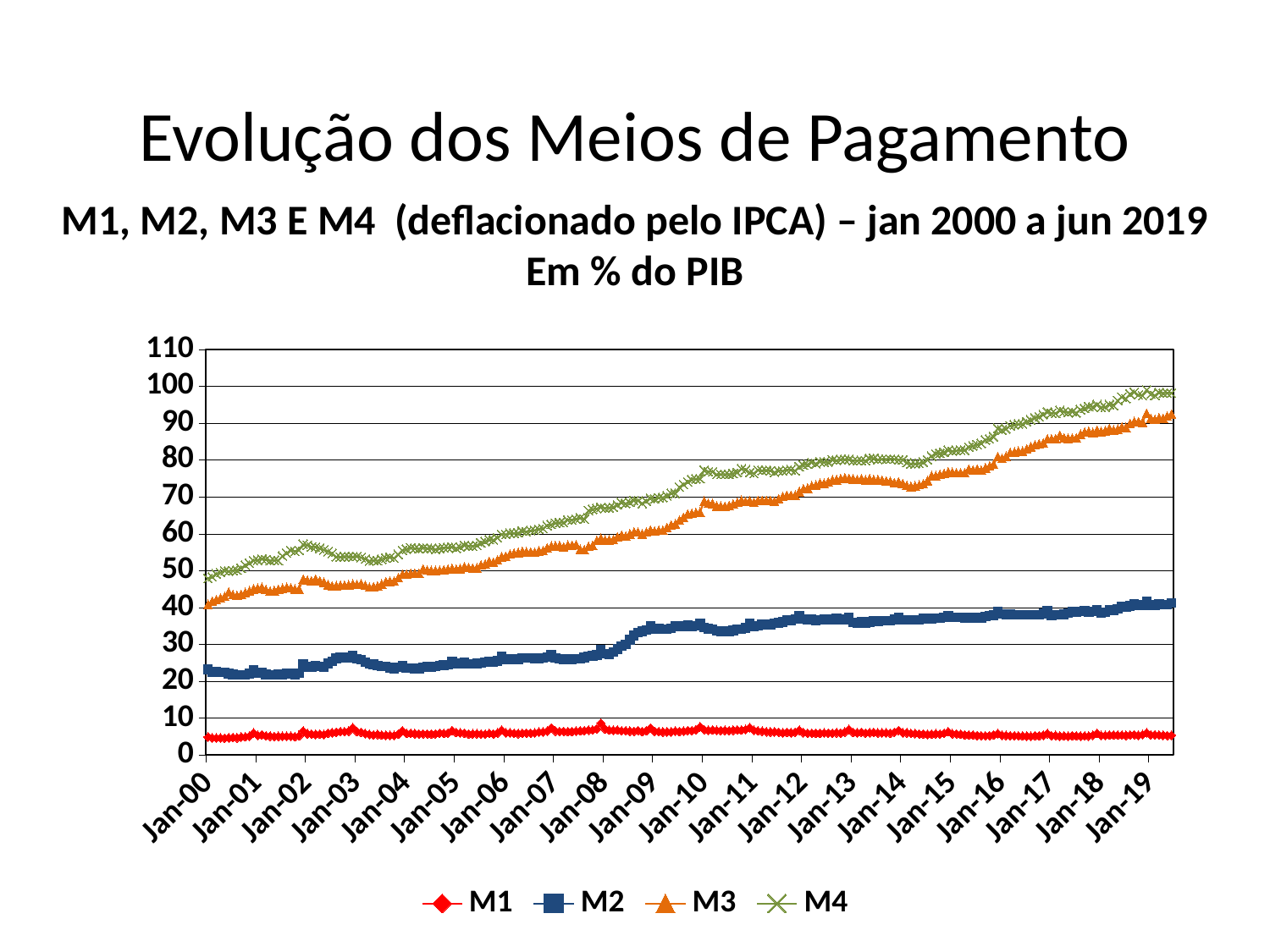
Is the value for M2 at Jan-10 greater or less than 30? greater Which series has the highest values across the chart? M4 Is the value for M1 at Jan-08 greater or less than 10? less At Jan-19, which is larger, M3 or M4? M4 How many series does the legend list? 4 Which series are listed in the legend? M1, M2, M3, M4 Is the value for M2 at Jan-00 greater or less than 20? greater What is the title of the slide? Evolução dos Meios de Pagamento Does the M4 series rise or fall from Jan-00 to Jan-19? rise What kind of chart is shown on the slide? line chart Which series has the lowest values across the chart? M1